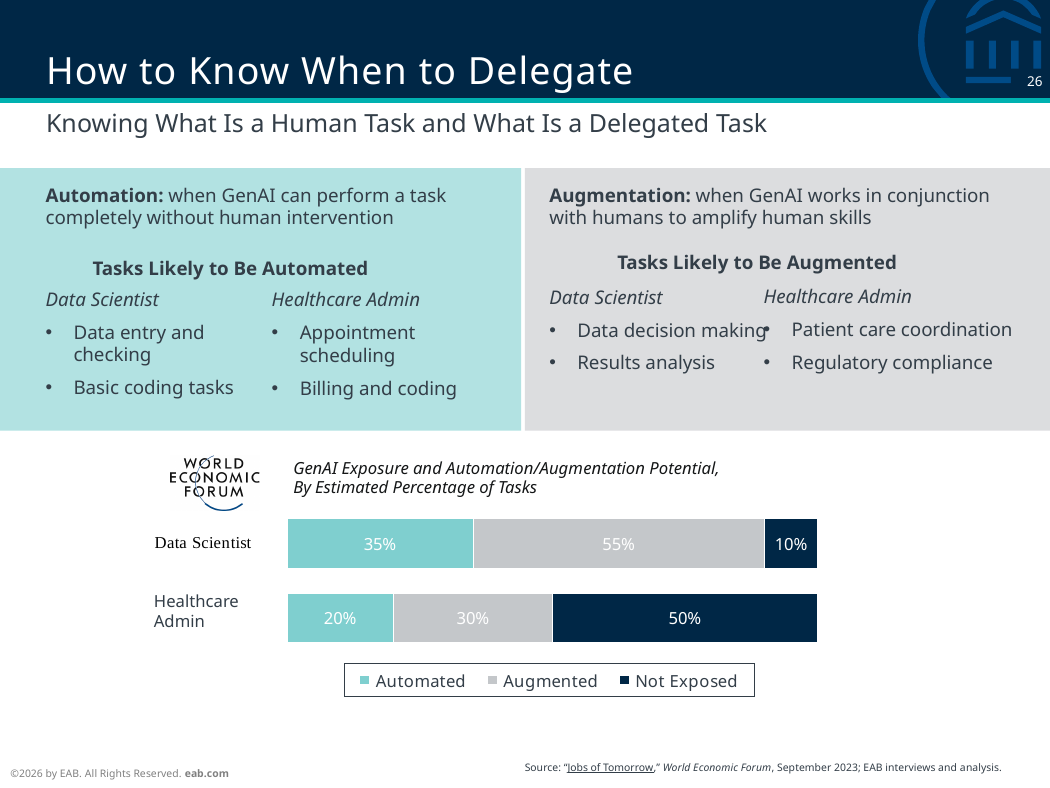
What percentage of Healthcare Admin tasks are shown as Augmented? 30% What is the total of the three segments in the Data Scientist bar? 100% Which category has the higher Not Exposed percentage, Data Scientist or Healthcare Admin? Healthcare Admin How many series does the chart legend list? 3 What percentage of Data Scientist tasks are shown as Augmented? 55% What percentage of Data Scientist tasks are shown as Automated? 35% How many categories are plotted in the chart? 2 What percentage of Healthcare Admin tasks are shown as Not Exposed? 50% What is the difference between the Augmented percentages for Data Scientist and Healthcare Admin? 25% What is the difference between the Not Exposed percentages for Healthcare Admin and Data Scientist? 40% What type of chart is shown on the slide? Stacked bar chart Which category has the higher Automated percentage? Data Scientist